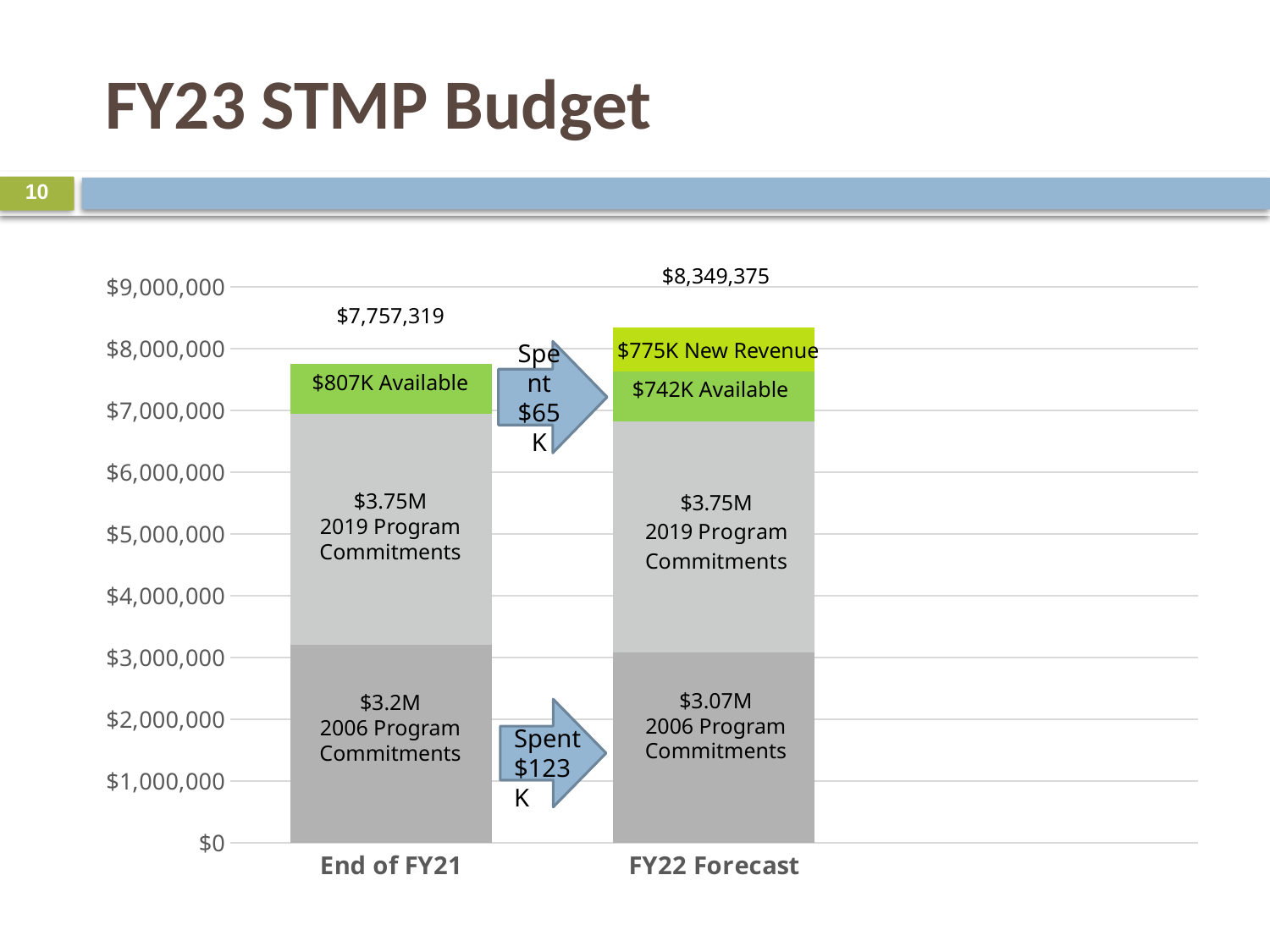
What is the value of the 2019 Program Commitments segment in the FY22 Forecast bar? $3.75M What is the value of the 2006 Program Commitments segment in the FY22 Forecast bar? $3.07M What is the total value printed above the End of FY21 bar? $7,757,319 What is the difference between the FY22 Forecast total and the End of FY21 total? $592,056 Which bar has the higher total, End of FY21 or FY22 Forecast? FY22 Forecast What is the total value printed above the FY22 Forecast bar? $8,349,375 What is the value of the 2006 Program Commitments segment in the End of FY21 bar? $3.2M How many bars (categories) are shown on the x axis? 2 What kind of chart is shown on the slide? Stacked bar chart Does the total rise or fall from End of FY21 to FY22 Forecast? Rise What is the value of the Available segment in the End of FY21 bar? $807K What is the value of the New Revenue segment in the FY22 Forecast bar? $775K